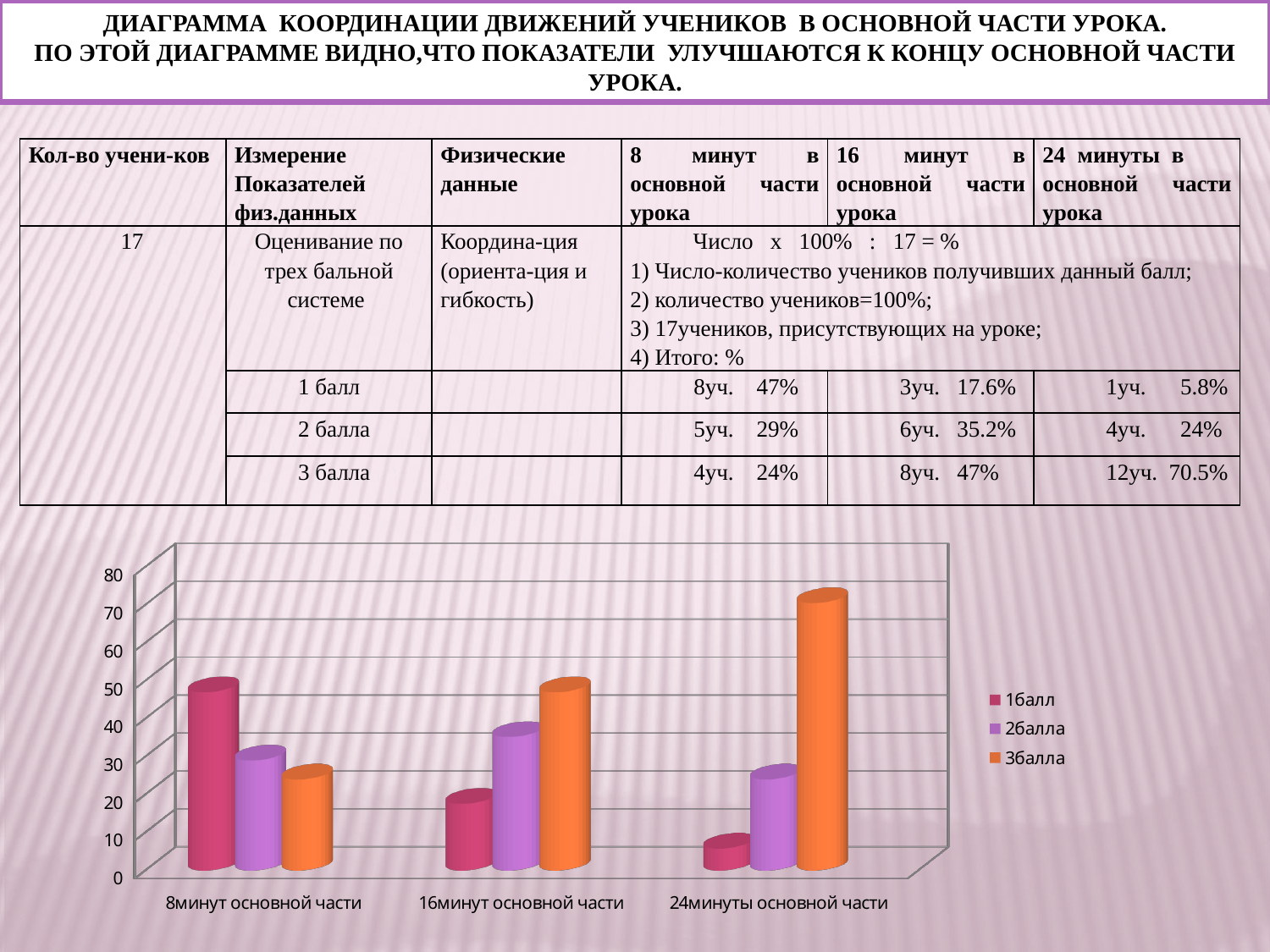
Which colour represents the 3балла series in the chart legend? orange Is the value for 1балл at 8минут основной части greater or less than 40? greater Do the values for the 3балла series rise or fall from left to right along the x axis? rise Which series has the tallest bar in the chart overall? 3балла How many series does the chart legend list? 3 Which is larger at 16минут основной части: the bar for 2балла or the bar for 1балл? 2балла Is the value for 3балла at 24минуты основной части greater or less than 60? greater What kind of chart is shown on the slide? bar chart In the category 24минуты основной части, which series has the lowest bar? 1балл How many categories are shown along the x axis of the chart? 3 Is the value for 1балл at 24минуты основной части greater or less than 10? less In the category 8минут основной части, which series has the highest bar? 1балл